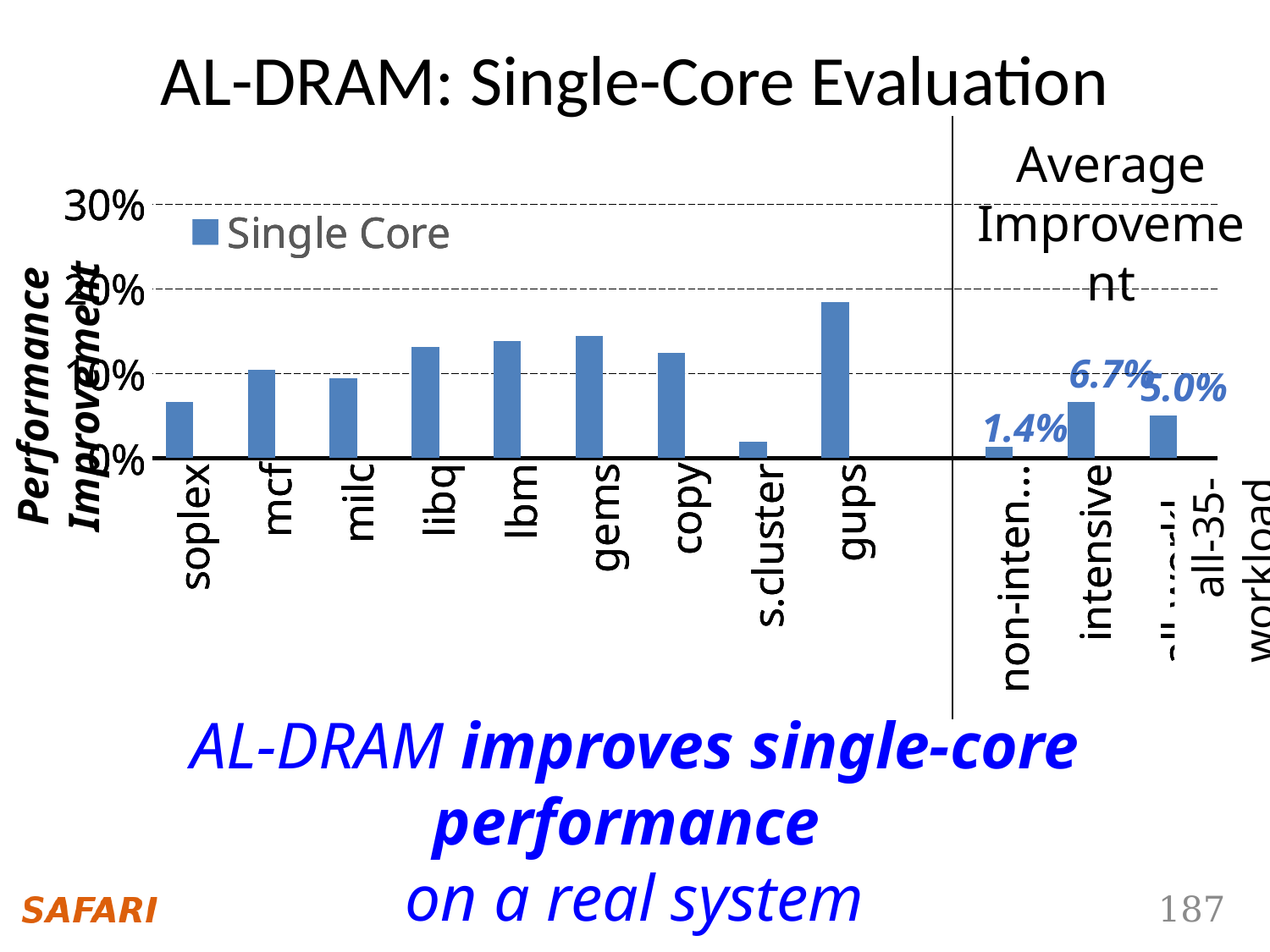
Which category has the highest bar? gups What is the value for the intensive category? 6.7% Is the value for gups greater or less than 10%? greater How many categories are plotted on the x axis? 12 Which is larger, the value for gups or the value for copy? gups What is the value for the all-35-workload category? 5.0% What is the value for the non-intensive category? 1.4% How many series does the legend list? 1 What is the difference between the intensive and non-intensive values? 5.3% Is the value for soplex greater or less than 10%? less What is the difference between the intensive and all-35-workload values? 1.7% What kind of chart is shown on the slide? bar chart